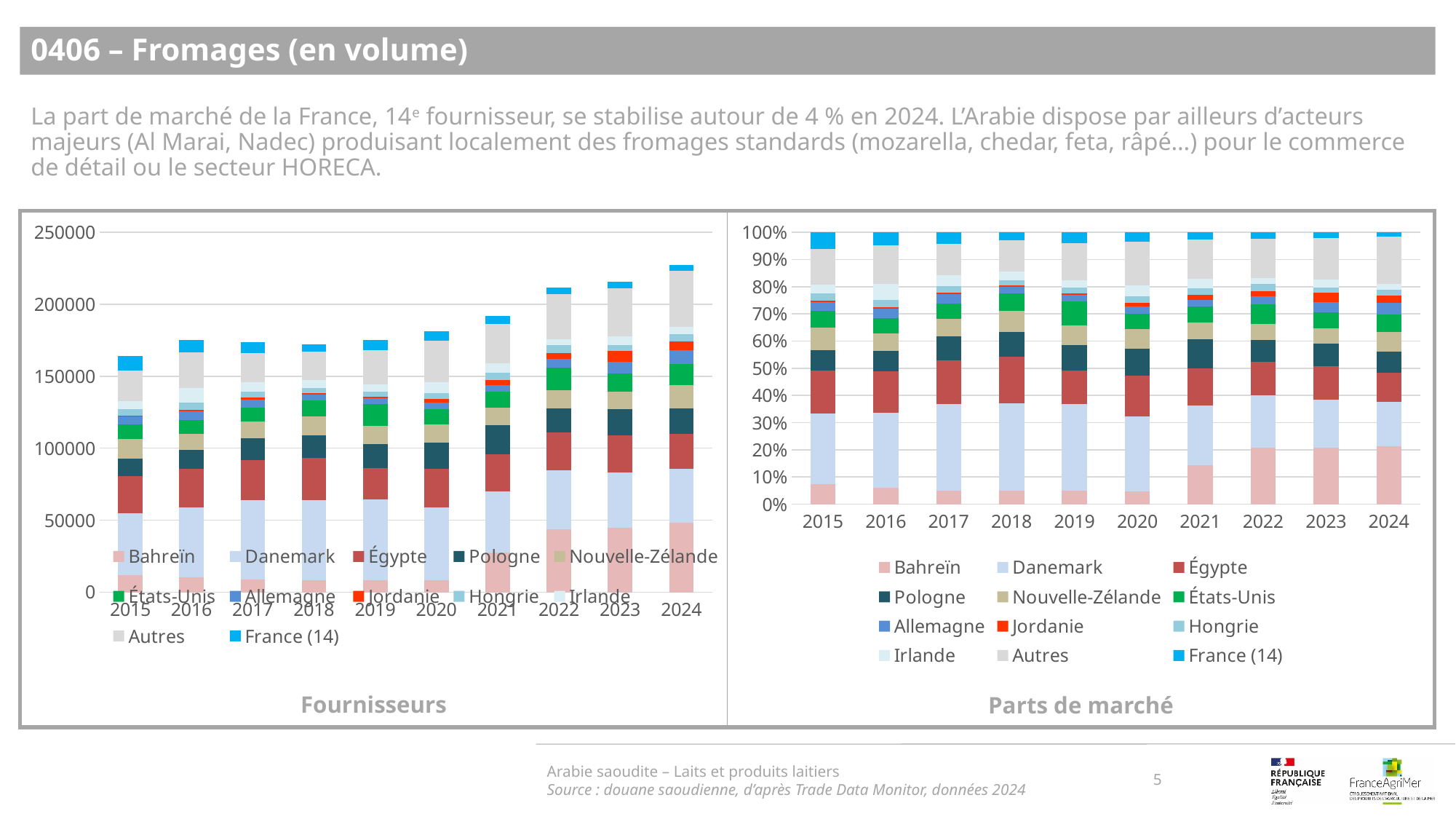
In the 'Parts de marché' chart, is the share of Bahreïn in 2015 greater or less than 10%? less In the 'Fournisseurs' chart, do the total volumes generally rise or fall from 2015 to 2024? rise In the 'Fournisseurs' chart, is the total for 2018 greater or less than 150000? greater In the 'Parts de marché' chart, is the share of Bahreïn larger in 2024 or in 2015? 2024 In the 'Parts de marché' chart, is the share of Bahreïn in 2024 greater or less than 10%? greater What kind of chart is the 'Fournisseurs' chart? bar chart How many years are shown on the x axis of the 'Parts de marché' chart? 10 How many series does the legend of the 'Parts de marché' chart list? 12 In the 'Fournisseurs' chart, which year has the lowest total bar? 2015 In the 'Fournisseurs' chart, which year has the highest total bar? 2024